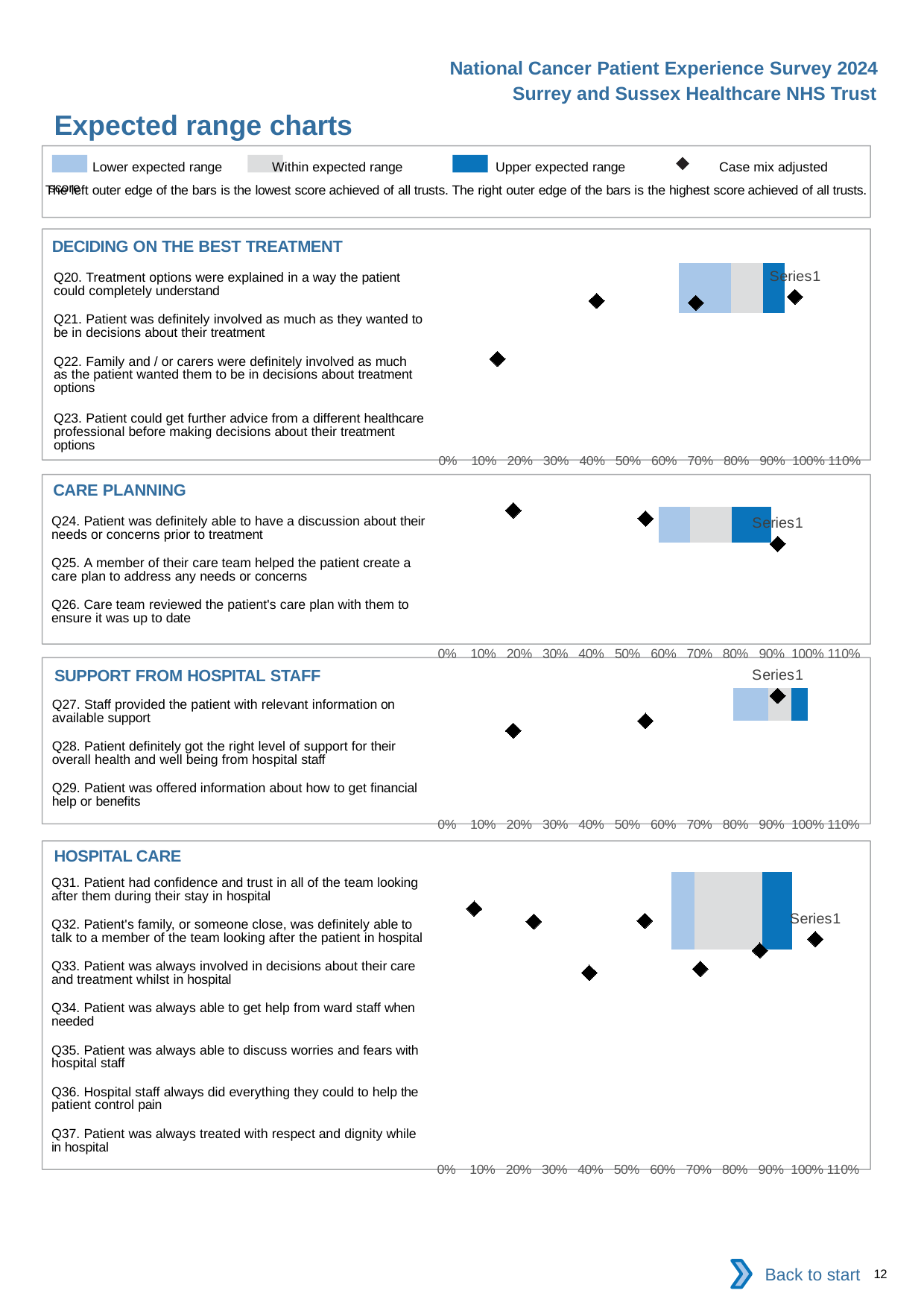
What kind of chart is used in the 'DECIDING ON THE BEST TREATMENT' section? Bar chart How many expected range charts are shown on the slide? 4 How many questions (categories) are listed in the 'CARE PLANNING' chart? 3 How many entries does the legend at the top of the slide list? 4 How many questions (categories) are listed in the 'SUPPORT FROM HOSPITAL STAFF' chart? 3 What is the lowest tick label shown on the x axis of the 'CARE PLANNING' chart? 0% Which legend entry is shown in dark blue? Upper expected range What is the highest tick label shown on the x axis of the 'HOSPITAL CARE' chart? 110%